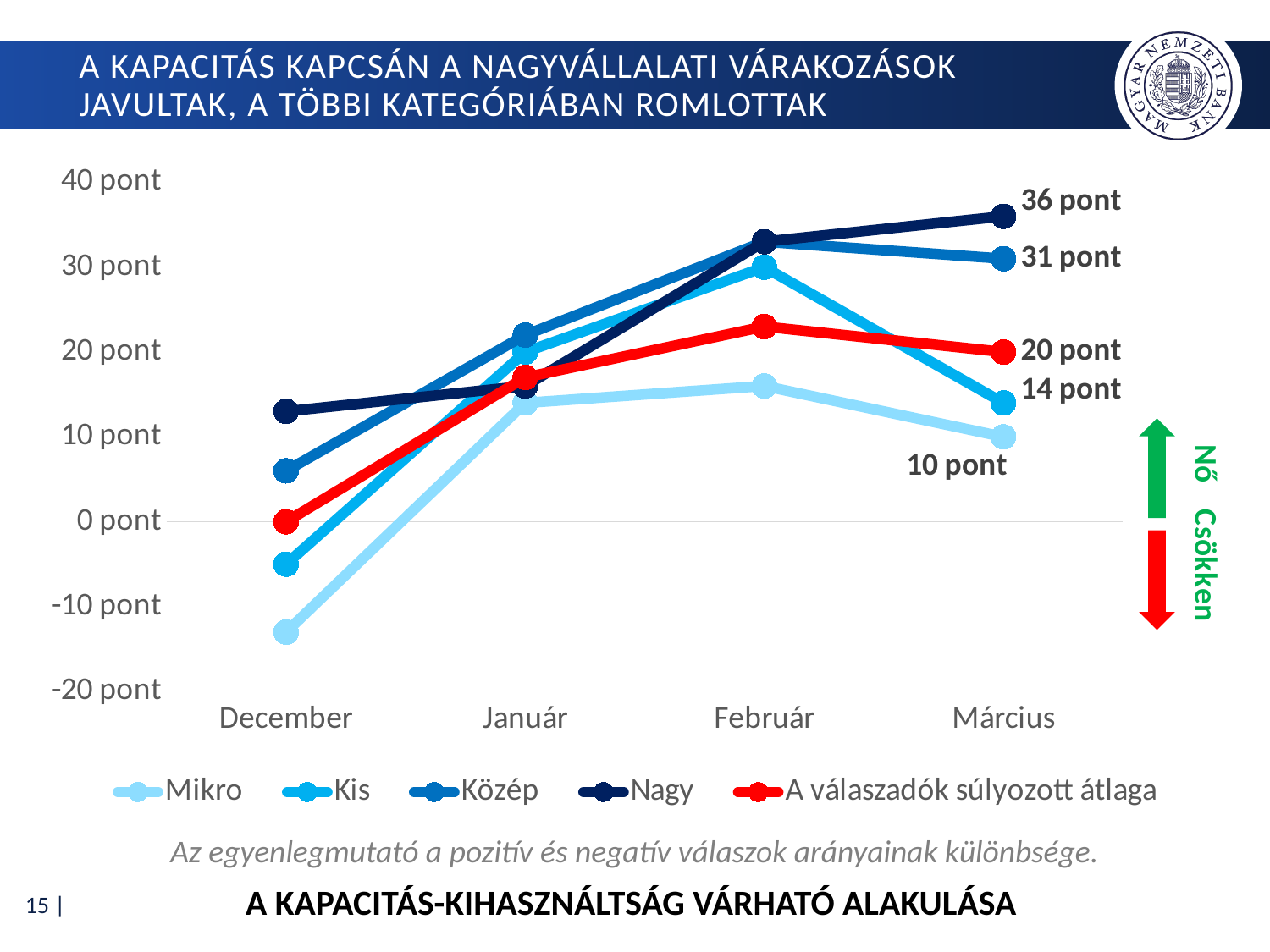
What is the value for Mikro in Március? 10 pont What is the value for Nagy in Március? 36 pont What is the value for A válaszadók súlyozott átlaga in Március? 20 pont In Március, which is larger: the value for Kis or the value for A válaszadók súlyozott átlaga? A válaszadók súlyozott átlaga Which series has the highest value in Március? Nagy What is the difference between the Nagy and Közép values in Március? 5 pont Is the value for Mikro in December greater or less than -10 pont? less Which series has the lowest value in Március? Mikro How many series does the legend list? 5 How many months are shown on the x axis? 4 Does the Nagy series rise or fall from December to Március? rises What kind of chart is shown on the slide? line chart